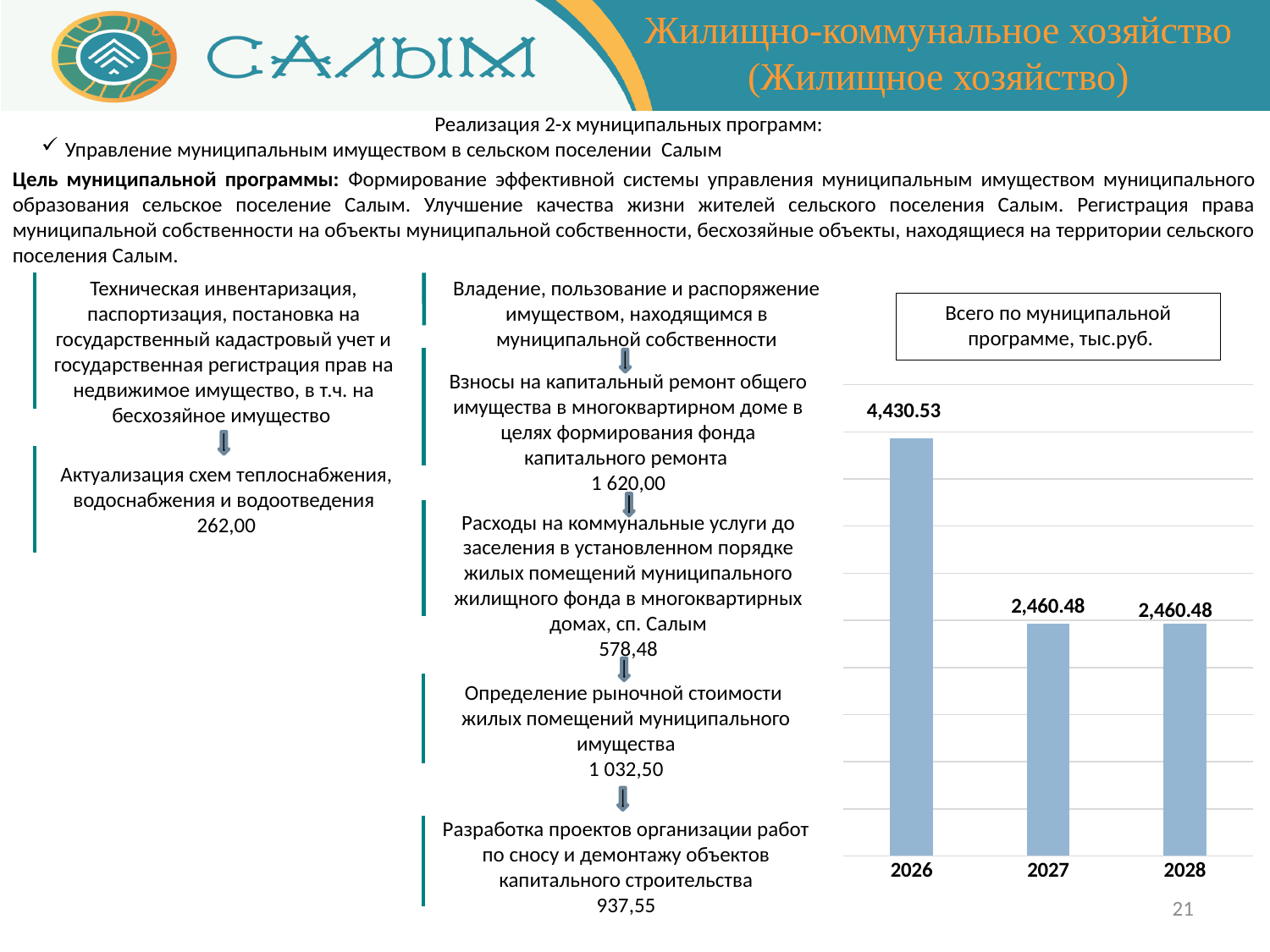
What is the value for 2028 in the chart? 2,460.48 Which is larger, the value for 2026 or the value for 2028? 2026 How many years are shown on the x axis of the chart? 3 Which year has the highest value in the chart? 2026 What is the value for 2026 in the chart? 4,430.53 Do the values rise or fall from 2026 to 2027? fall What kind of chart is shown on the slide? bar chart What is the sum of the values for 2026, 2027 and 2028? 9,351.49 Are the values for 2027 and 2028 the same or different? the same What is the title of the chart? Всего по муниципальной программе, тыс.руб. What is the difference between the values for 2026 and 2027? 1,970.05 What is the value for 2027 in the chart? 2,460.48